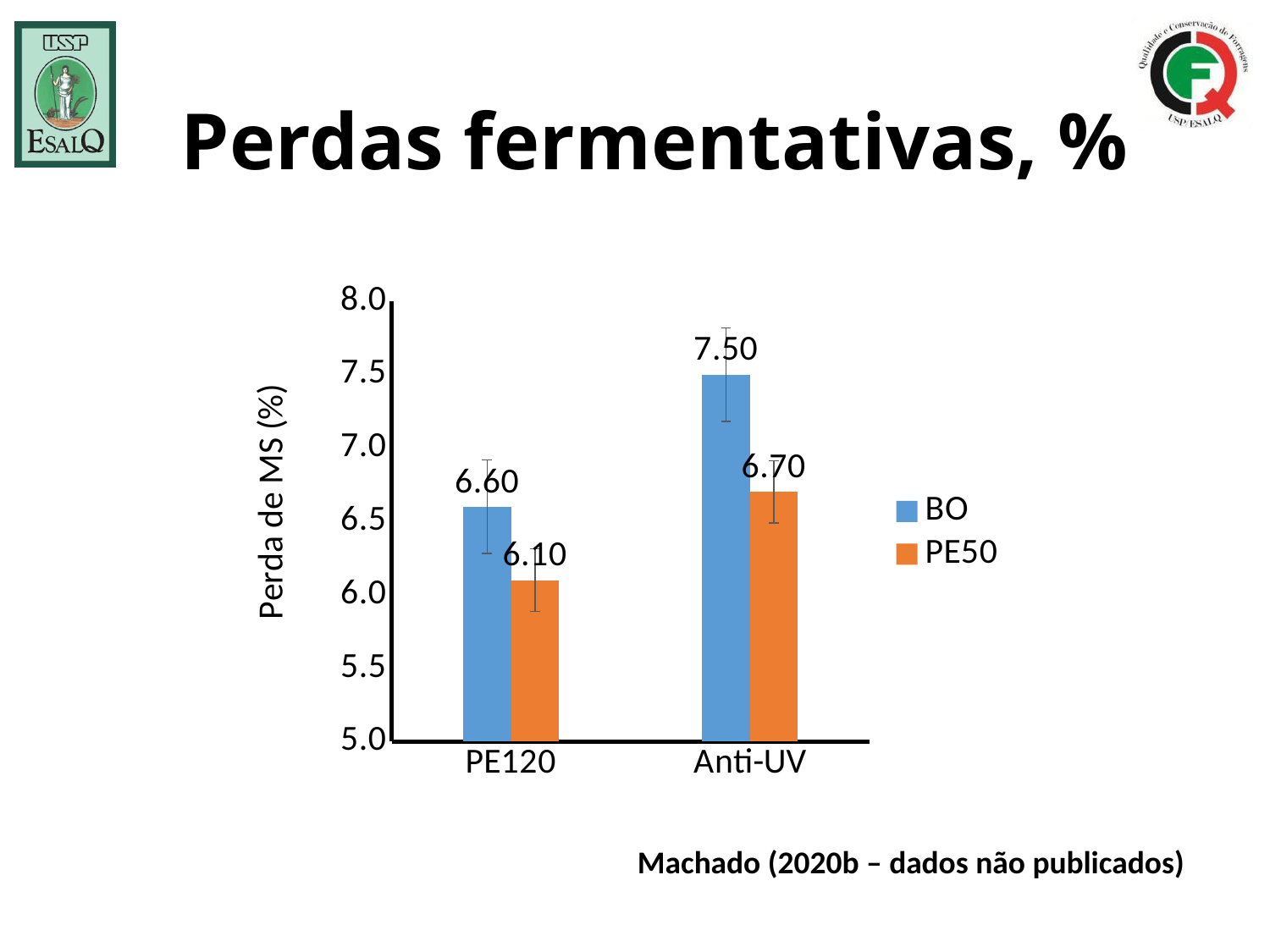
How many series does the legend list? 2 What kind of chart is shown on the slide? Bar chart What is the difference between the BO values for Anti-UV and PE120? 0.90 What is the difference between the BO and PE50 values in the Anti-UV category? 0.80 Is the BO value for Anti-UV greater or less than 7.0? greater Which is larger, the BO value for PE120 or the PE50 value for Anti-UV? PE50 value for Anti-UV What is the value for PE50 in the Anti-UV category? 6.70 How many categories are shown on the x axis? 2 Which category has the highest BO value? Anti-UV What is the value for BO in the PE120 category? 6.60 Which bar has the lowest value on the chart? PE50 in PE120 What is the value for PE50 in the PE120 category? 6.10